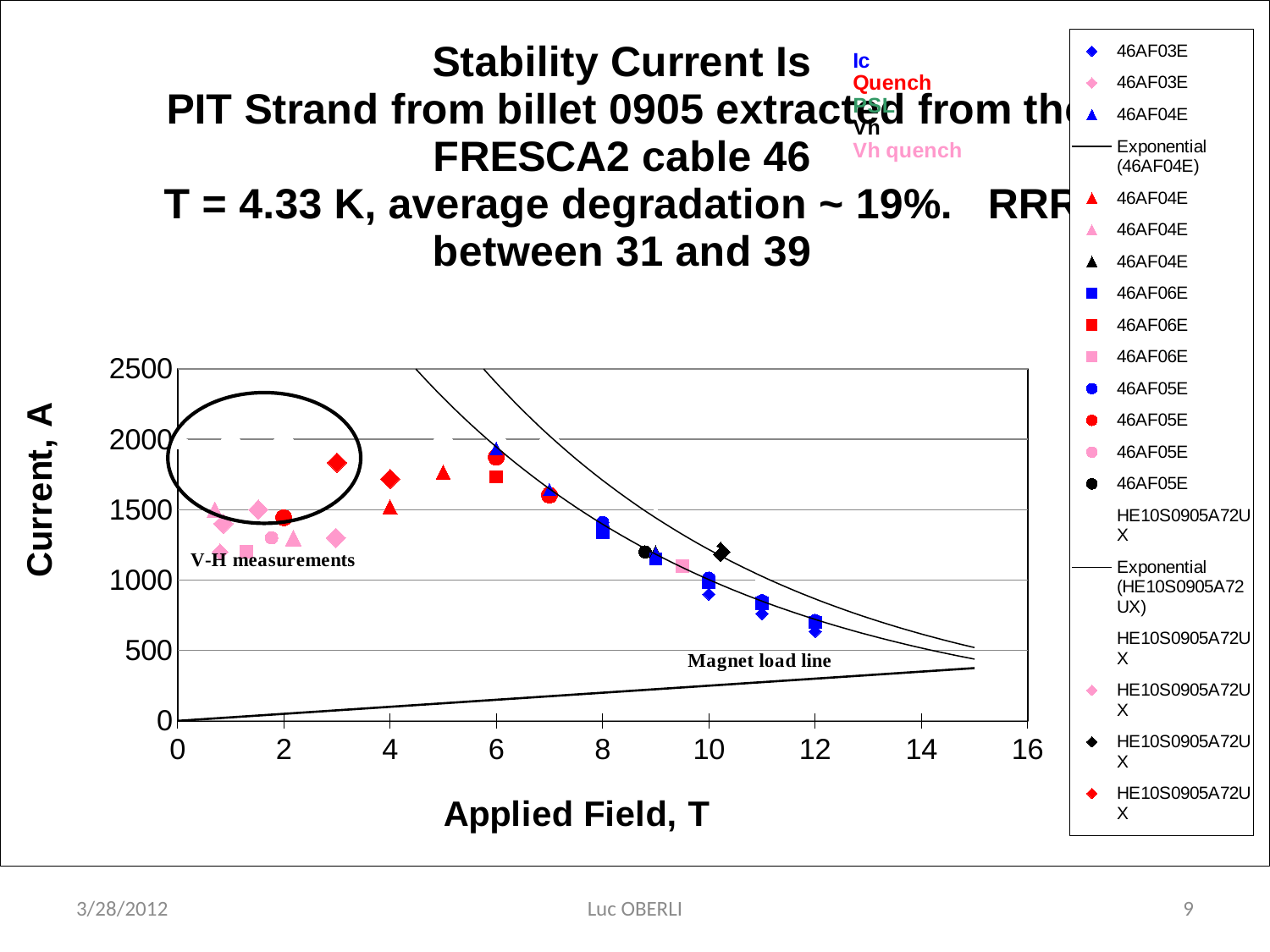
Are the measured current values at an applied field of 12 T greater or less than 1000 A? less Are the measured current values at an applied field of 8 T greater or less than 1000 A? greater Between 6 T and 12 T, do the measured current values rise or fall as the applied field increases? fall Are the measured current values at an applied field of 6 T greater or less than 1500 A? greater Which is larger, the measured current at 6 T or the measured current at 12 T? 6 T What kind of chart is shown on the slide? scatter chart What label is written next to the straight line rising from the origin in the chart? Magnet load line What is the highest value shown on the vertical axis of the chart? 2500 What is the title of the horizontal axis of the chart? Applied Field, T